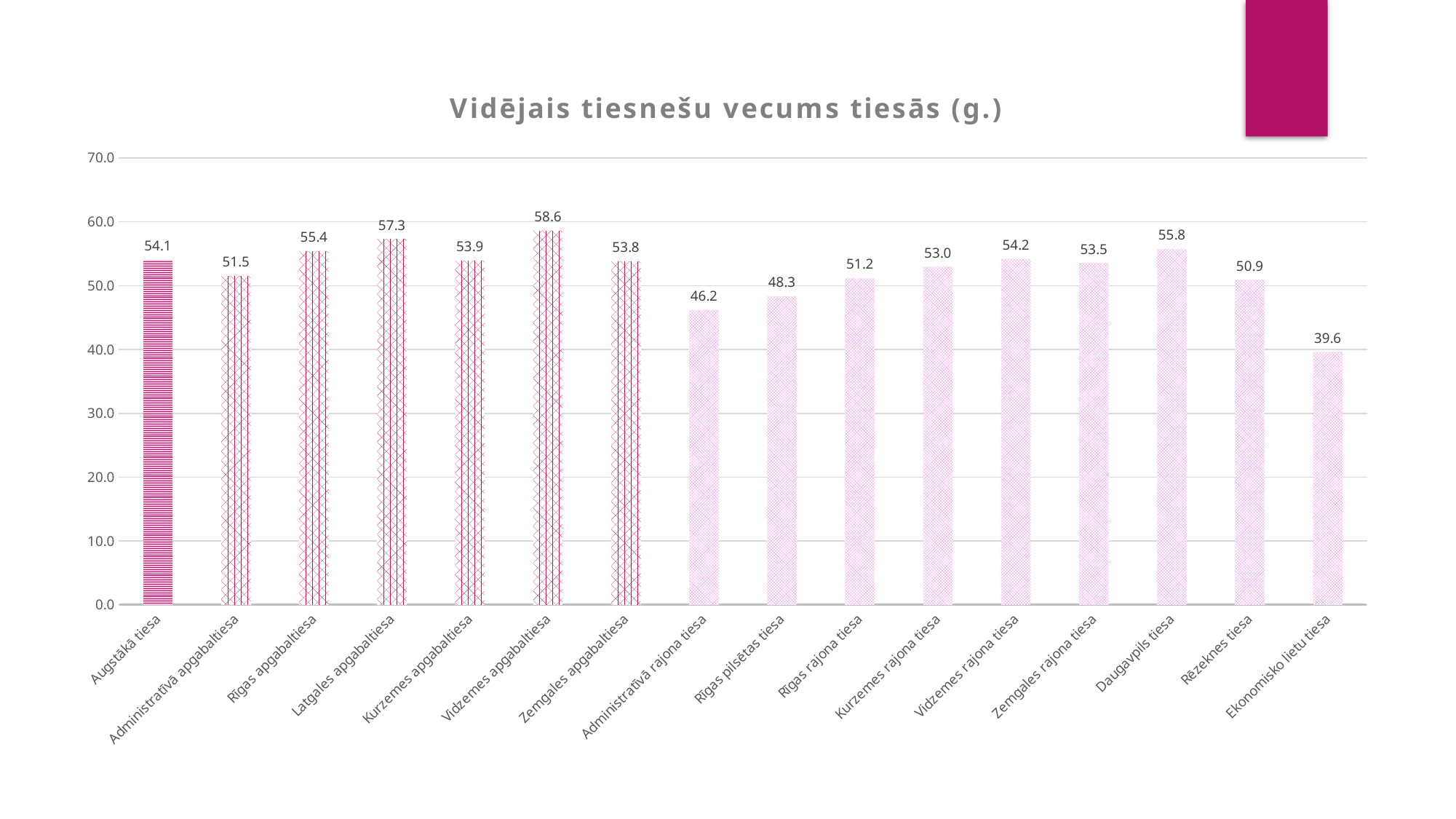
Which court has the highest value in the chart? Vidzemes apgabaltiesa What is the value shown for Ekonomisko lietu tiesa? 39.6 Is the value for Rīgas rajona tiesa greater or less than 50.0? greater What is the title of the chart? Vidējais tiesnešu vecums tiesās (g.) What is the value shown for Rīgas pilsētas tiesa? 48.3 What is the difference between the values for Latgales apgabaltiesa and Administratīvā rajona tiesa? 11.1 What type of chart is shown on the slide? Bar chart Which has a larger value, Daugavpils tiesa or Rēzeknes tiesa? Daugavpils tiesa How many courts (bars) are shown in the chart? 16 Which court has the lowest value in the chart? Ekonomisko lietu tiesa What is the value shown for Augstākā tiesa? 54.1 What is the value shown for Vidzemes apgabaltiesa? 58.6